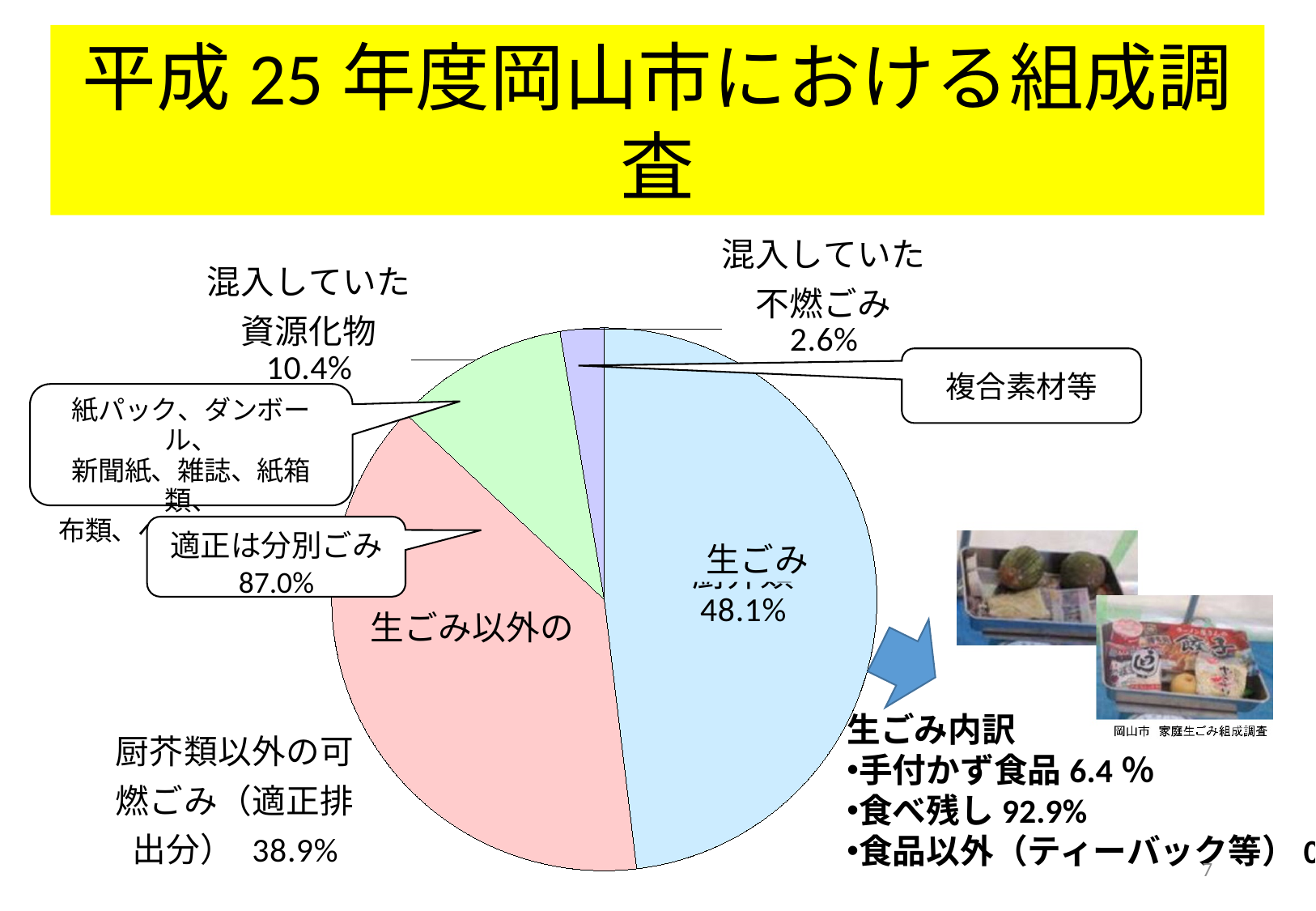
Which is larger, the 混入していた資源化物 slice or the 混入していた不燃ごみ slice? 混入していた資源化物 Which slice of the pie is the smallest? 混入していた不燃ごみ What colour is the 生ごみ (厨芥類) slice of the pie? light blue What is the combined share of the two 混入していた slices (資源化物 and 不燃ごみ)? 13.0% Which slice of the pie is the largest? 生ごみ (厨芥類) What percentage of the pie is 厨芥類以外の可燃ごみ（適正排出分）? 38.9% What is the difference in percentage points between 生ごみ (48.1%) and 厨芥類以外の可燃ごみ (38.9%)? 9.2 percentage points What percentage of the pie is 生ごみ (厨芥類)? 48.1% What percentage of the pie is 混入していた不燃ごみ? 2.6% How many slices does the pie chart have? 4 What percentage of the pie is 混入していた資源化物? 10.4% What type of chart is shown on the slide? pie chart